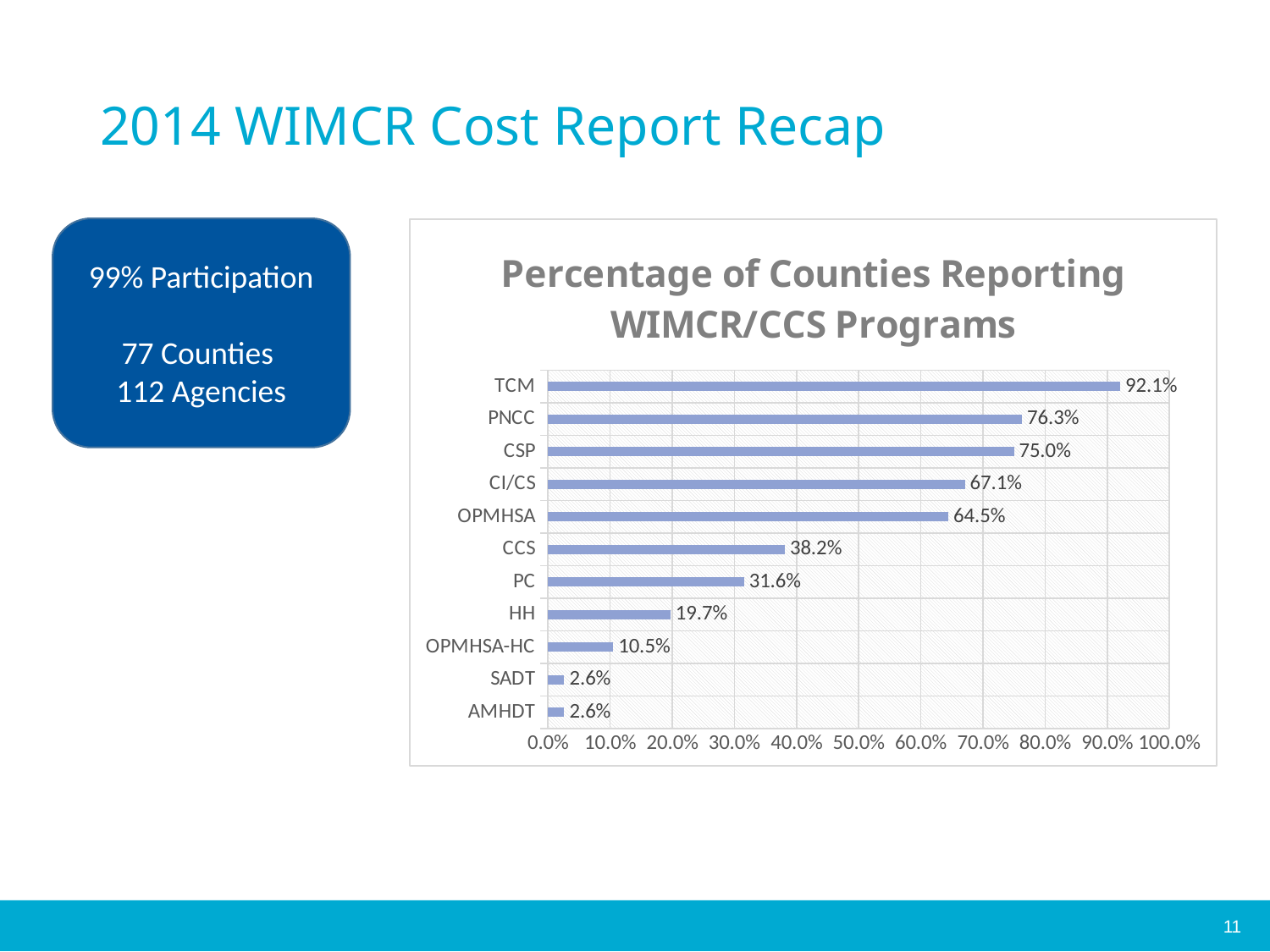
Which has a larger value, CI/CS or OPMHSA? CI/CS What kind of chart is shown on the slide? Bar chart Which program has the highest percentage of counties reporting? TCM How many programs are shown on the chart? 11 What is the difference between the values for TCM and HH? 72.4% What percentage of counties reported the TCM program? 92.1% What is the highest value shown on the x axis of the chart? 100.0% What is the value shown for CCS? 38.2% What percentage of counties reported OPMHSA-HC? 10.5% What is the title of the chart? Percentage of Counties Reporting WIMCR/CCS Programs Which has a larger value, PC or HH? PC What is the difference between the values for PNCC and CSP? 1.3%